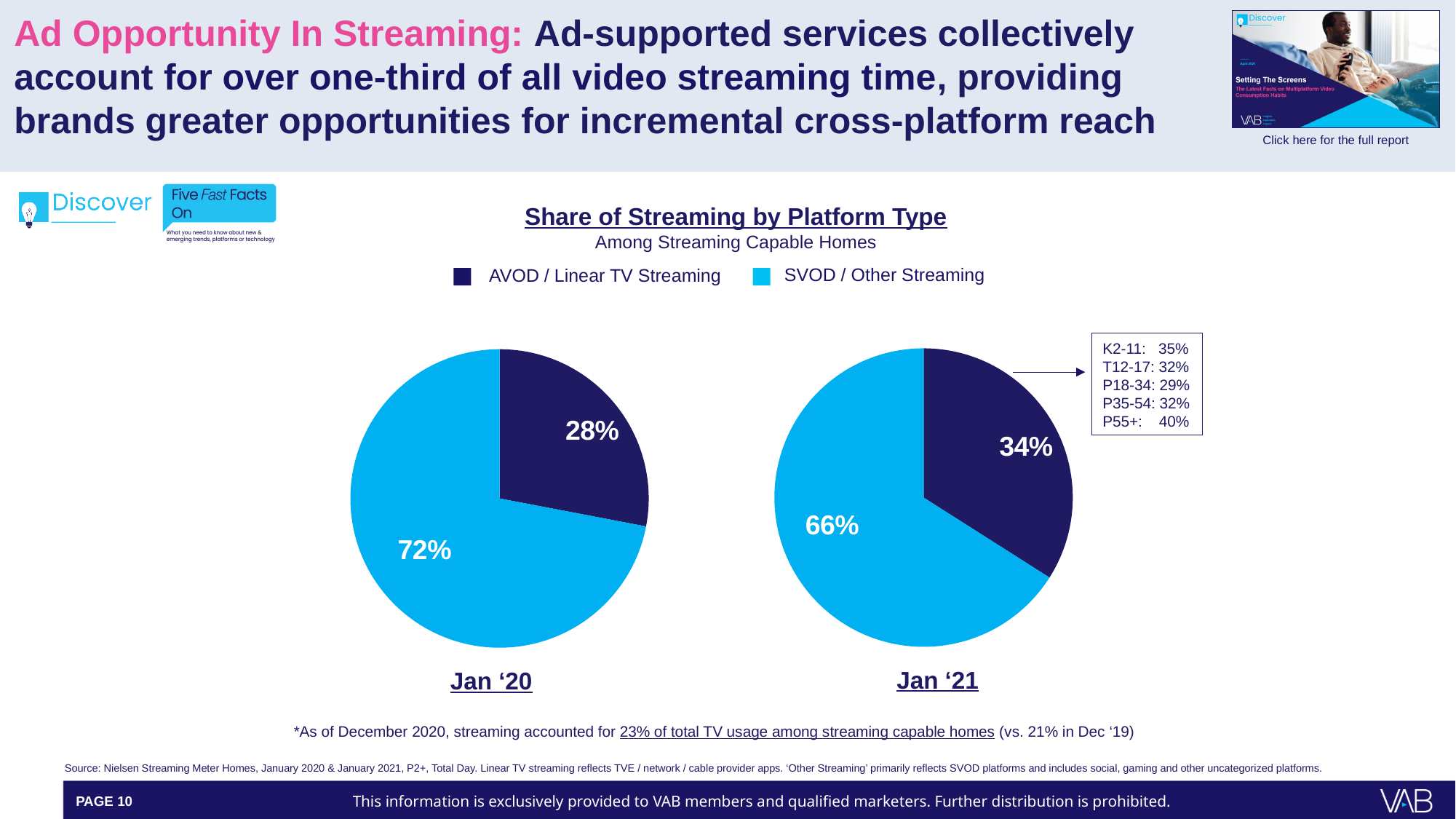
Is the SVOD / Other Streaming share larger in the Jan '20 chart or the Jan '21 chart? Jan '20 In the Jan '20 pie chart, what share does SVOD / Other Streaming have? 72% In the Jan '20 pie chart, what share does AVOD / Linear TV Streaming have? 28% What is the title of the pie charts? Share of Streaming by Platform Type What type of chart is used to show the share of streaming by platform type? Pie chart In the Jan '20 pie chart, which slice is the smallest? AVOD / Linear TV Streaming In the Jan '21 pie chart, what share does SVOD / Other Streaming have? 66% In the Jan '21 pie chart, what share does AVOD / Linear TV Streaming have? 34% How many series does the legend list for the pie charts? 2 In the Jan '21 chart's callout box, what is the AVOD / Linear TV Streaming share for P55+? 40% In the Jan '21 pie chart, which slice is the largest? SVOD / Other Streaming By how many percentage points did the AVOD / Linear TV Streaming share change from the Jan '20 chart to the Jan '21 chart? 6 percentage points